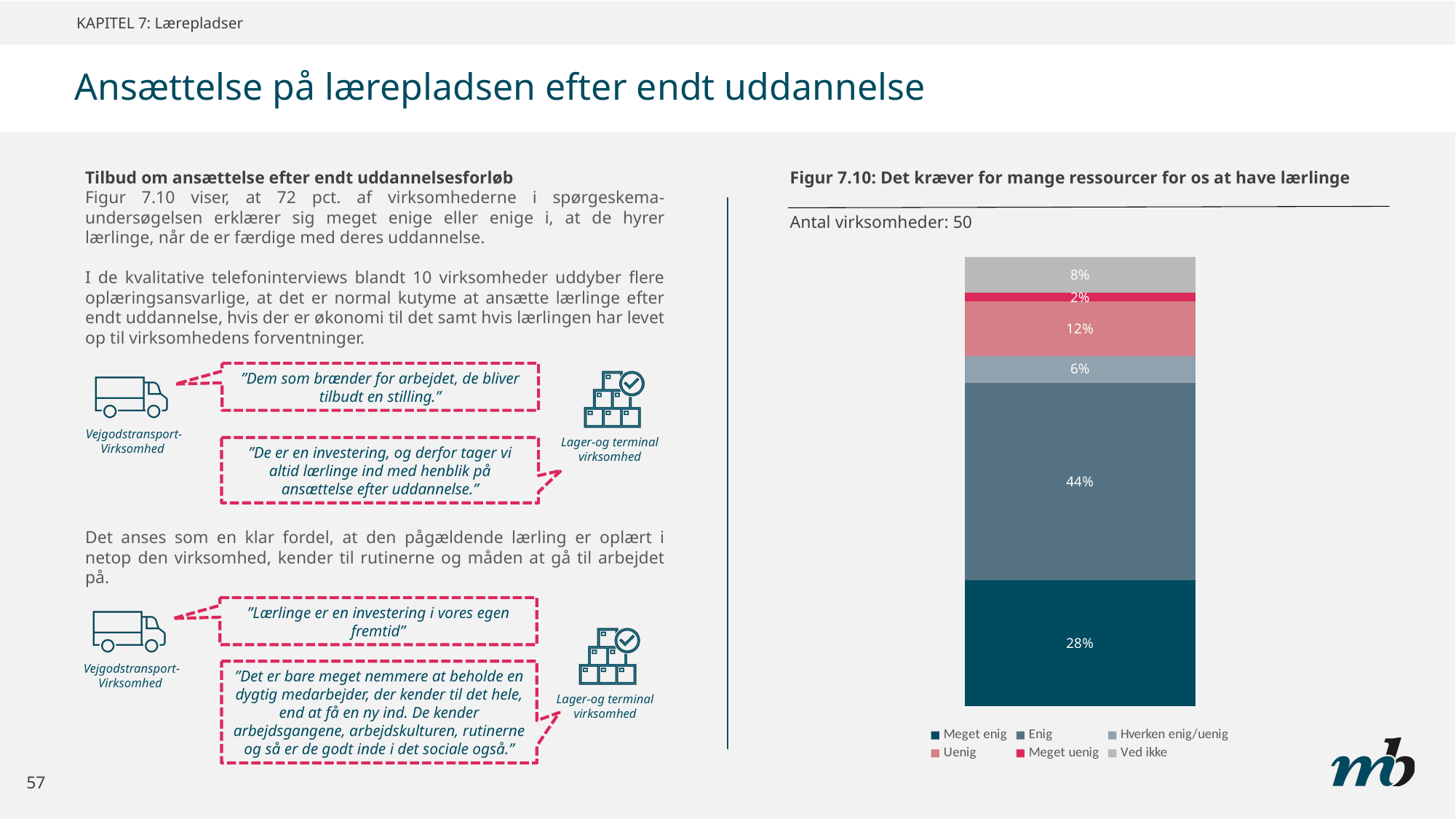
In Figur 7.10, what is the difference in percentage points between "Enig" and "Meget enig"? 16 percentage points According to the text above the chart in Figur 7.10, how many companies were surveyed? 50 In Figur 7.10, which response category has the smallest share? Meget uenig In Figur 7.10, which is larger: the share for "Uenig" or the share for "Ved ikke"? Uenig In Figur 7.10, what percentage of companies answered "Hverken enig/uenig"? 6% How many series does the legend of Figur 7.10 list? 6 In Figur 7.10, what percentage of companies answered "Enig"? 44% In Figur 7.10, which response category has the largest share? Enig What type of chart is shown in Figur 7.10? Stacked bar chart In Figur 7.10, what percentage of companies answered "Ved ikke"? 8% In Figur 7.10, what percentage of companies answered "Uenig"? 12% In Figur 7.10, what percentage of companies answered "Meget enig"? 28%